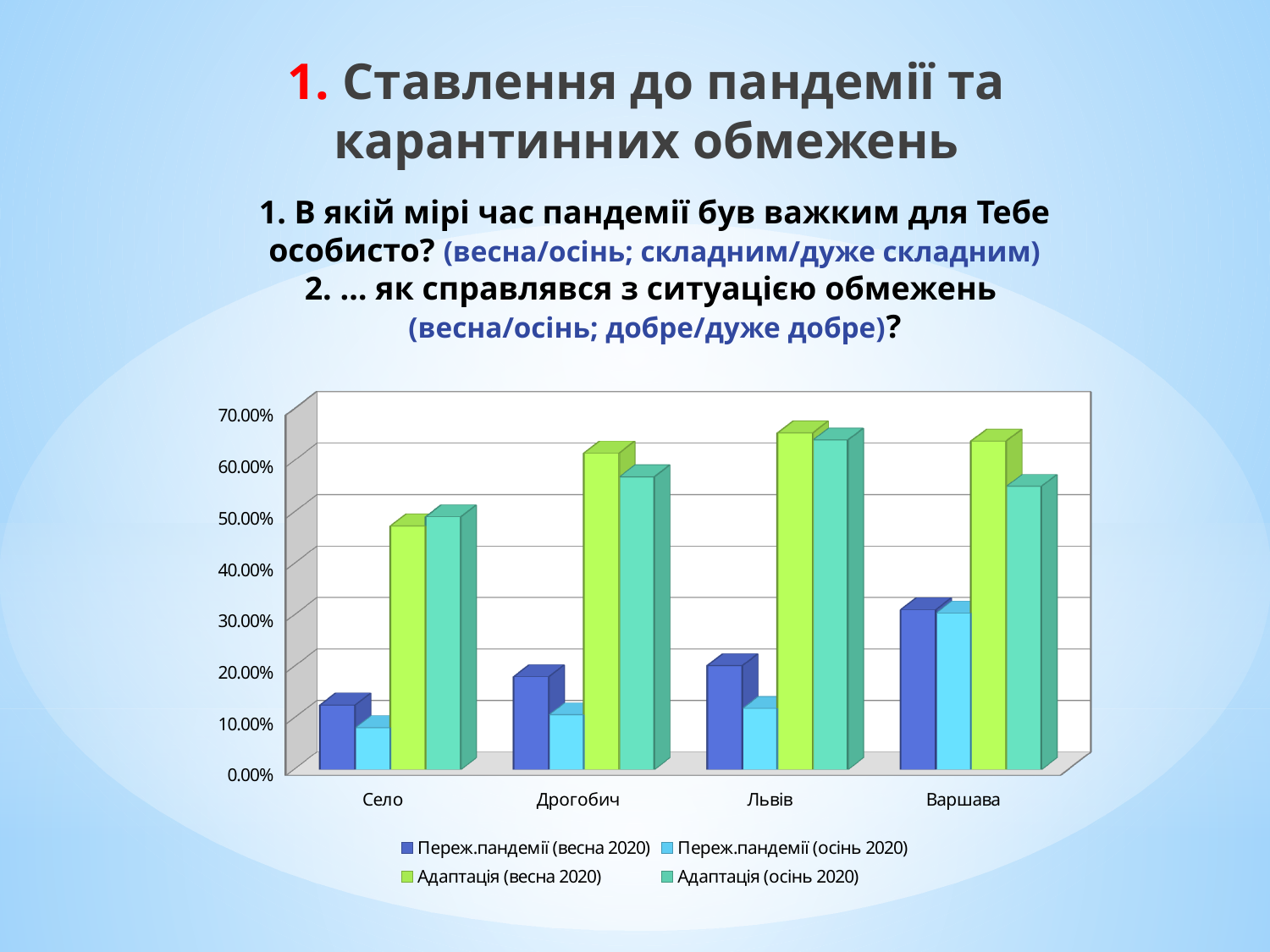
How many series does the chart's legend list? 4 For the series Адаптація (весна 2020), which is larger: the value for Село or the value for Дрогобич? Дрогобич Is the value for Львів in the series Адаптація (весна 2020) greater or less than 60.00%? greater Which category has the lowest value for the series Адаптація (весна 2020)? Село What kind of chart is shown on the slide? bar chart Is the value for Село in the series Адаптація (весна 2020) greater or less than 60.00%? less Which category has the highest value for the series Переж.пандемії (весна 2020)? Варшава Which category has the highest value for the series Переж.пандемії (осінь 2020)? Варшава What is the first series listed in the chart's legend? Переж.пандемії (весна 2020) Is the value for Варшава in the series Переж.пандемії (весна 2020) greater or less than 20.00%? greater Which category has the highest value for the series Адаптація (осінь 2020)? Львів How many categories are shown on the x axis of the chart? 4